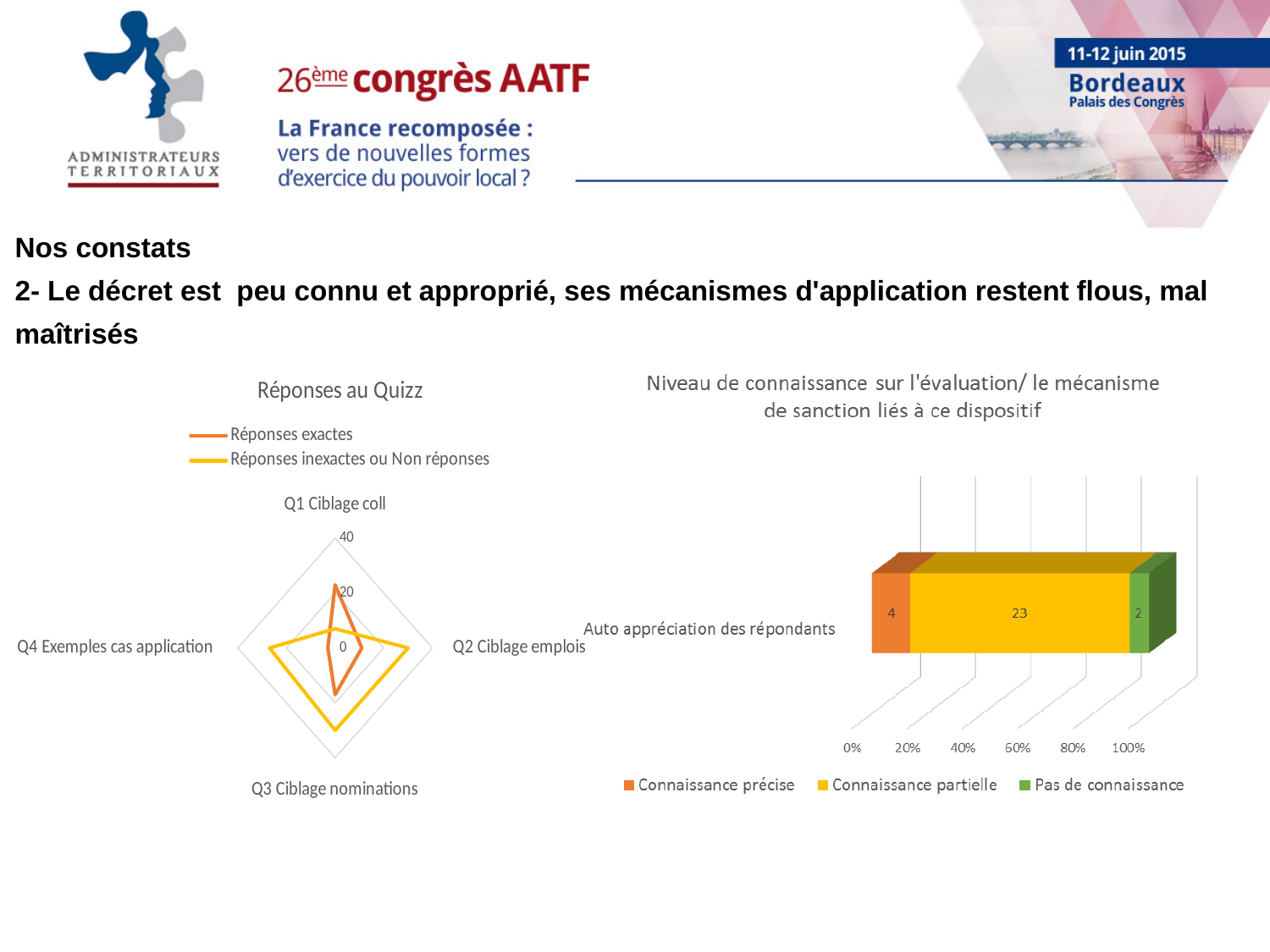
In the chart titled 'Niveau de connaissance sur l'évaluation/ le mécanisme de sanction liés à ce dispositif', how many series does the legend list? 3 In the chart titled 'Niveau de connaissance sur l'évaluation/ le mécanisme de sanction liés à ce dispositif', what is the difference between 'Connaissance partielle' and 'Connaissance précise'? 19 In the chart titled 'Niveau de connaissance sur l'évaluation/ le mécanisme de sanction liés à ce dispositif', which series has the highest value? Connaissance partielle In the chart titled 'Niveau de connaissance sur l'évaluation/ le mécanisme de sanction liés à ce dispositif', which series has the lowest value? Pas de connaissance In the chart titled 'Réponses au Quizz', is the value of 'Réponses inexactes ou Non réponses' for 'Q2 Ciblage emplois' greater or less than 20? greater In the chart titled 'Réponses au Quizz', which series has the larger value for 'Q3 Ciblage nominations'? Réponses inexactes ou Non réponses In the chart titled 'Niveau de connaissance sur l'évaluation/ le mécanisme de sanction liés à ce dispositif', what is the value for 'Pas de connaissance'? 2 In the chart titled 'Niveau de connaissance sur l'évaluation/ le mécanisme de sanction liés à ce dispositif', what is the value for 'Connaissance précise'? 4 What kind of chart is the chart titled 'Réponses au Quizz'? Radar chart In the chart titled 'Niveau de connaissance sur l'évaluation/ le mécanisme de sanction liés à ce dispositif', what is the total of the stacked bar for 'Auto appréciation des répondants'? 29 In the chart titled 'Niveau de connaissance sur l'évaluation/ le mécanisme de sanction liés à ce dispositif', what is the value for 'Connaissance partielle'? 23 In the chart titled 'Réponses au Quizz', how many categories are plotted? 4